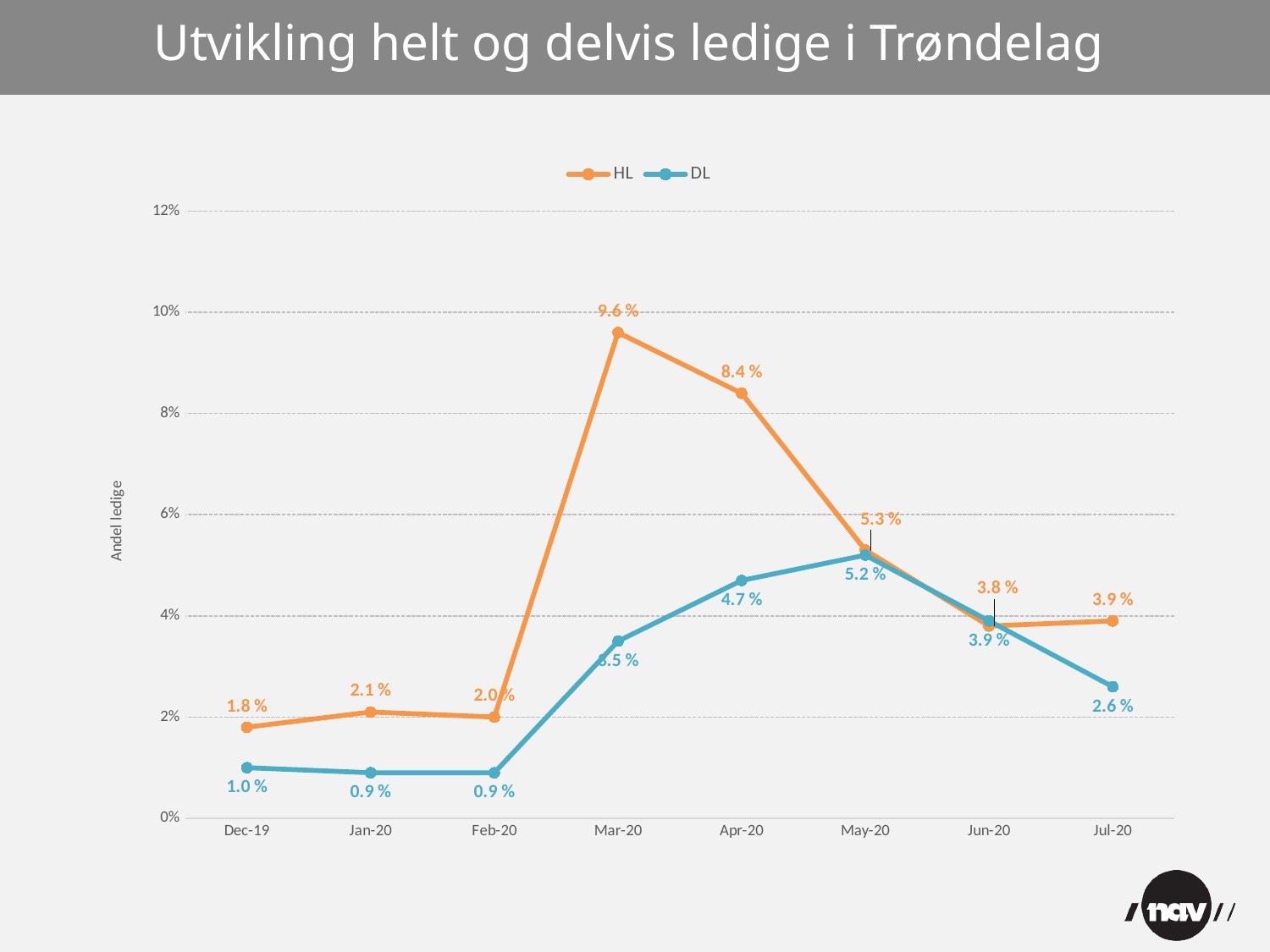
What is the difference between the HL values for Mar-20 and Apr-20? 1.2 % Does the DL series rise or fall from May-20 to Jul-20? Fall What type of chart is shown on the slide? Line chart What is the DL value for Apr-20? 4.7 % What is the HL value for Dec-19? 1.8 % In which month does the HL series reach its highest value? Mar-20 How many series does the legend list? 2 How many months are shown on the x axis? 8 What is the HL value for Mar-20? 9.6 % In which month does the DL series reach its highest value? May-20 Which series has the larger value in Apr-20, HL or DL? HL What is the DL value for Jul-20? 2.6 %